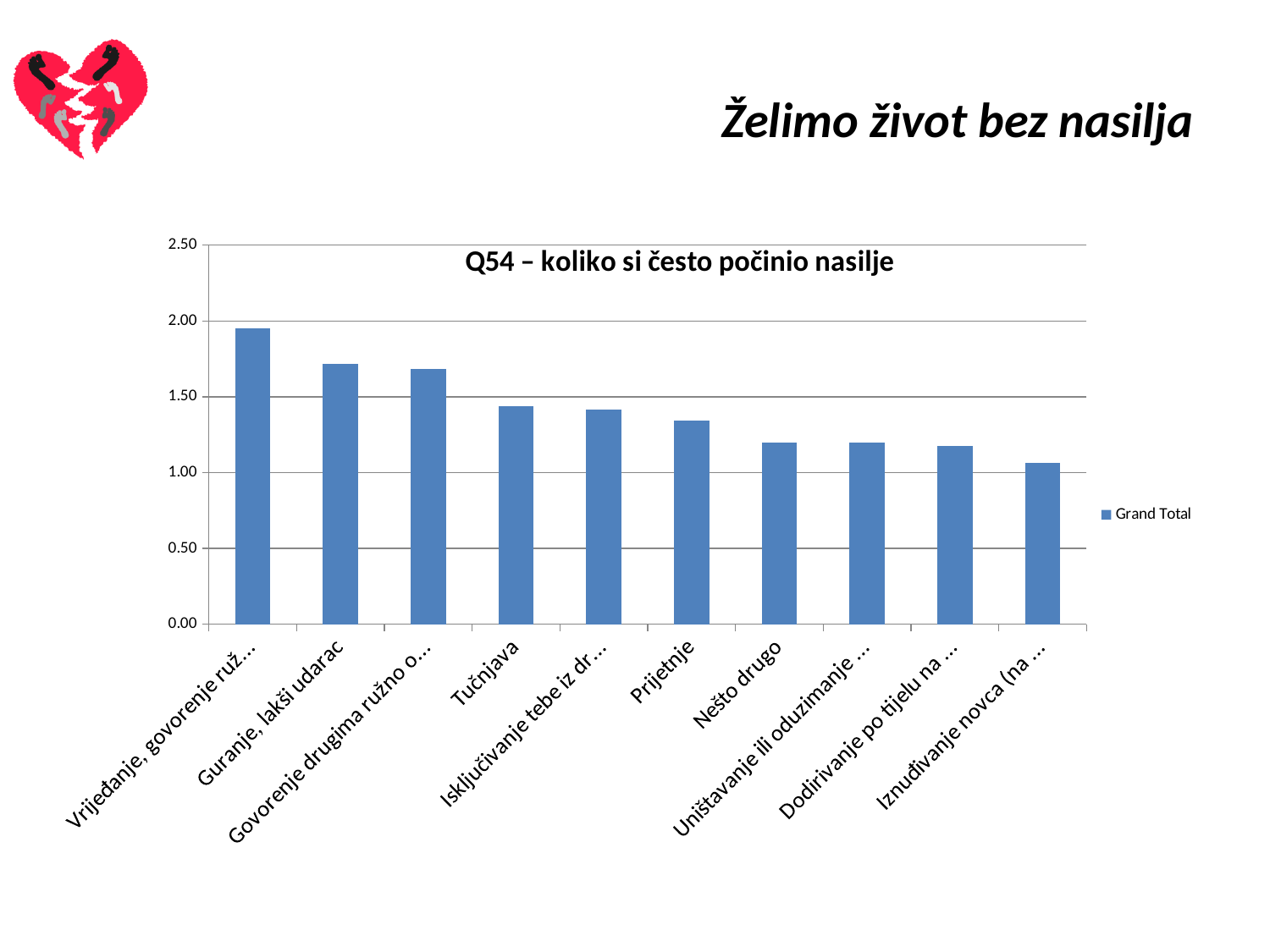
What series name is shown in the chart legend? Grand Total What is the title of the chart? Q54 – koliko si često počinio nasilje Is the value for Tučnjava greater or less than 1.50? less Is the value for Guranje, lakši udarac greater or less than 1.50? greater Which has the larger value, Guranje, lakši udarac or Prijetnje? Guranje, lakši udarac What kind of chart is shown on the slide? bar chart Which category has the lowest value in the chart? Iznuđivanje novca (na … Do the values generally rise or fall from left to right along the x axis? fall How many categories are plotted in the chart? 10 How many series does the chart legend list? 1 Is the value for Nešto drugo greater or less than 1.00? greater Which category has the highest value in the chart? Vrijeđanje, govorenje ruž…